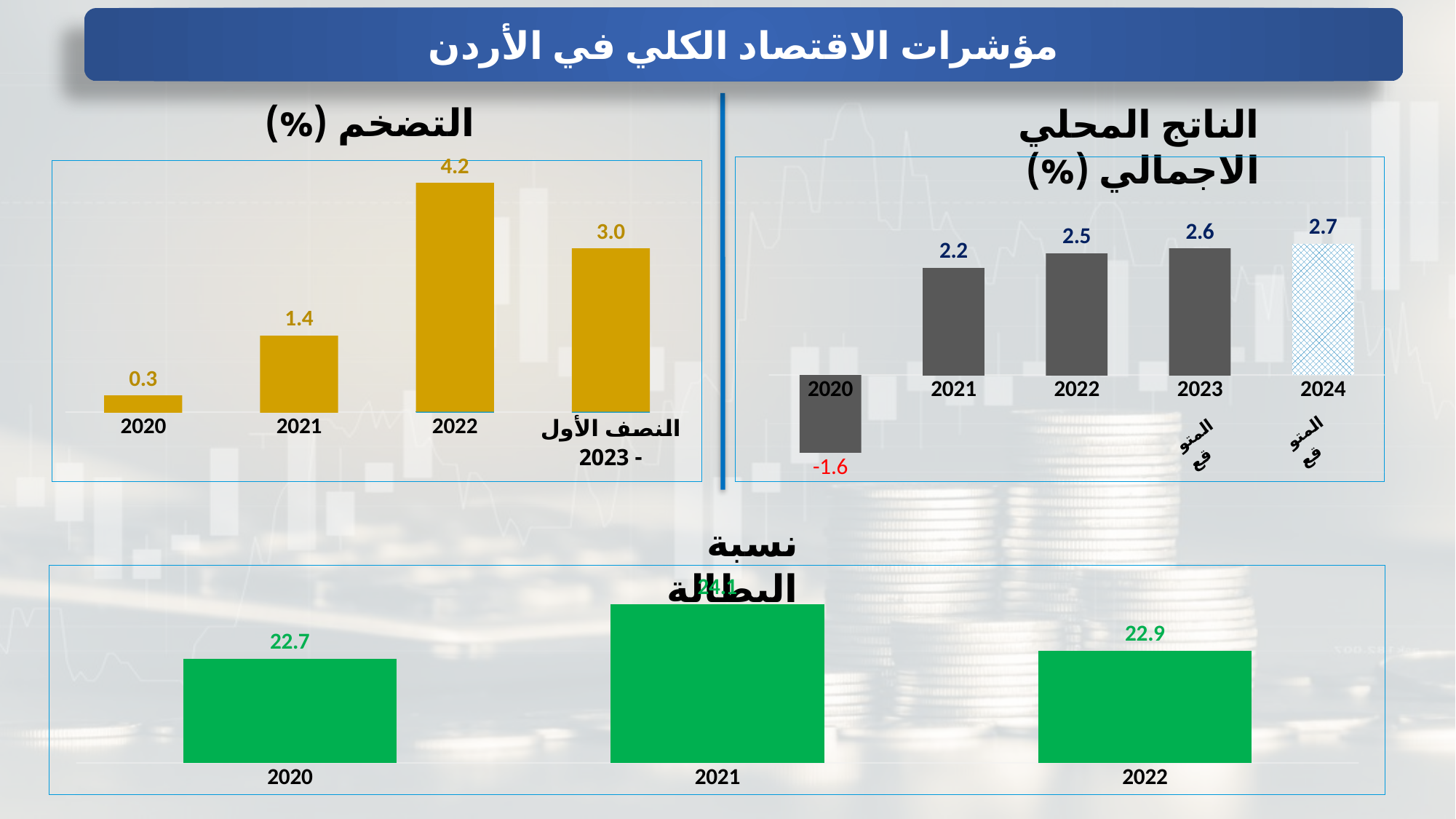
In the unemployment chart (نسبة البطالة), which year has the highest value? 2021 In the unemployment chart (نسبة البطالة), what is the value for 2022? 22.9 In the inflation chart (التضخم), what is the value for 2020? 0.3 In the GDP chart (الناتج المحلي الاجمالي), which year has the lowest value? 2020 In the inflation chart (التضخم), which year has the highest value? 2022 In the GDP chart (الناتج المحلي الاجمالي), what is the forecast value for 2024? 2.7 In the inflation chart (التضخم), what is the value for 2022? 4.2 What kind of chart is the unemployment chart (نسبة البطالة)? bar chart In the inflation chart (التضخم), what is the difference between the 2022 value and the 2021 value? 2.8 In the GDP chart (الناتج المحلي الاجمالي), what is the value for 2020? -1.6 In the inflation chart (التضخم), how many bars are plotted? 4 In the GDP chart (الناتج المحلي الاجمالي), do the values rise or fall from 2021 to 2024? rise